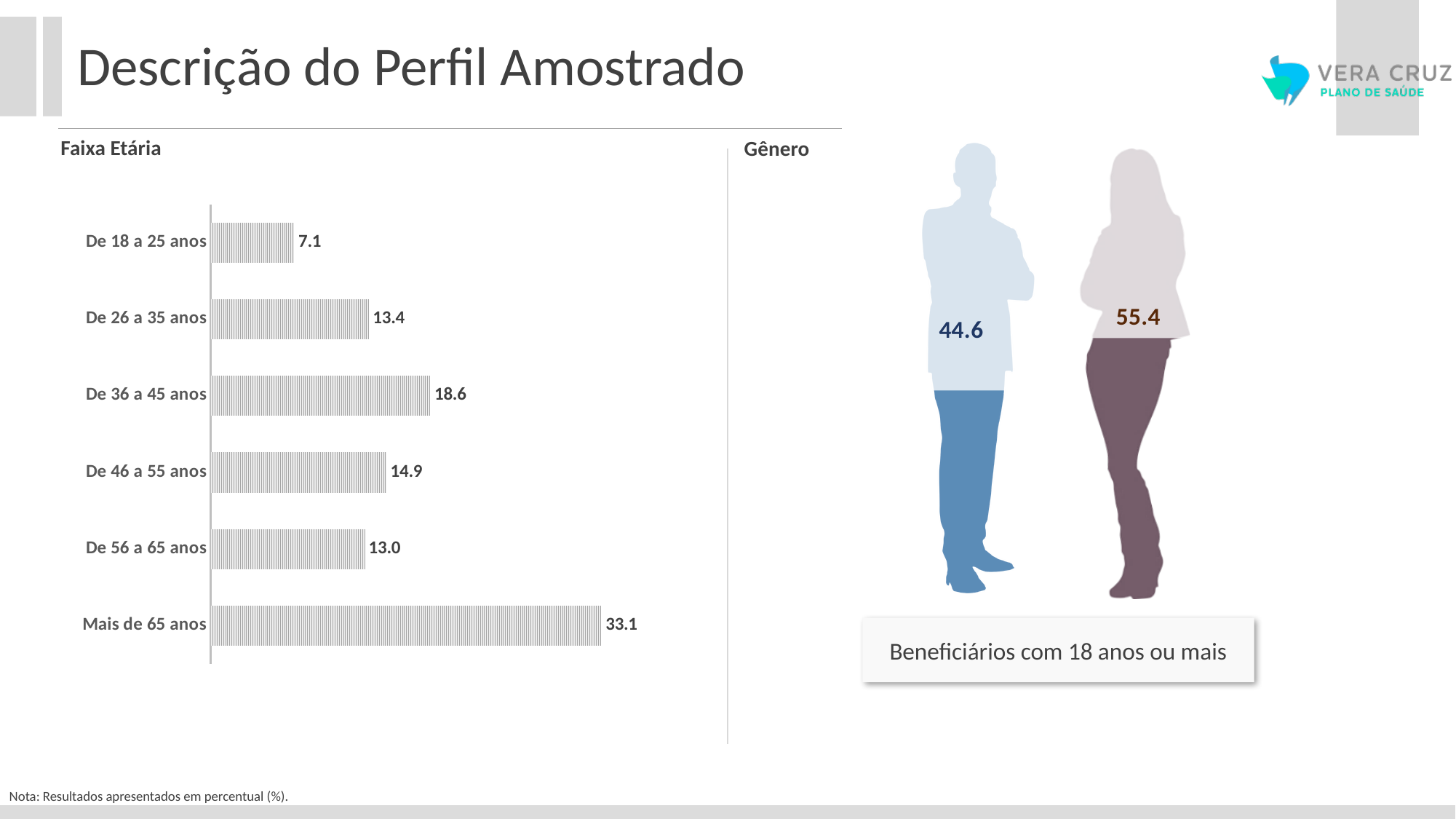
In the Faixa Etária chart, what is the difference between the values for Mais de 65 anos and De 36 a 45 anos? 14.5 In the Faixa Etária chart, what is the value for De 36 a 45 anos? 18.6 How many age groups are shown in the Faixa Etária chart? 6 In the Faixa Etária chart, which age group has the lowest value? De 18 a 25 anos In the Gênero section, what is the value shown for the female figure? 55.4 What type of chart is the Faixa Etária chart? Bar chart In the Faixa Etária chart, which is larger: the value for De 26 a 35 anos or De 46 a 55 anos? De 46 a 55 anos In the Faixa Etária chart, what is the value for De 56 a 65 anos? 13.0 In the Faixa Etária chart, what is the difference between the values for De 46 a 55 anos and De 26 a 35 anos? 1.5 In the Gênero section, what is the value shown for the male figure? 44.6 In the Faixa Etária chart, what is the value for De 18 a 25 anos? 7.1 In the Faixa Etária chart, which age group has the highest value? Mais de 65 anos